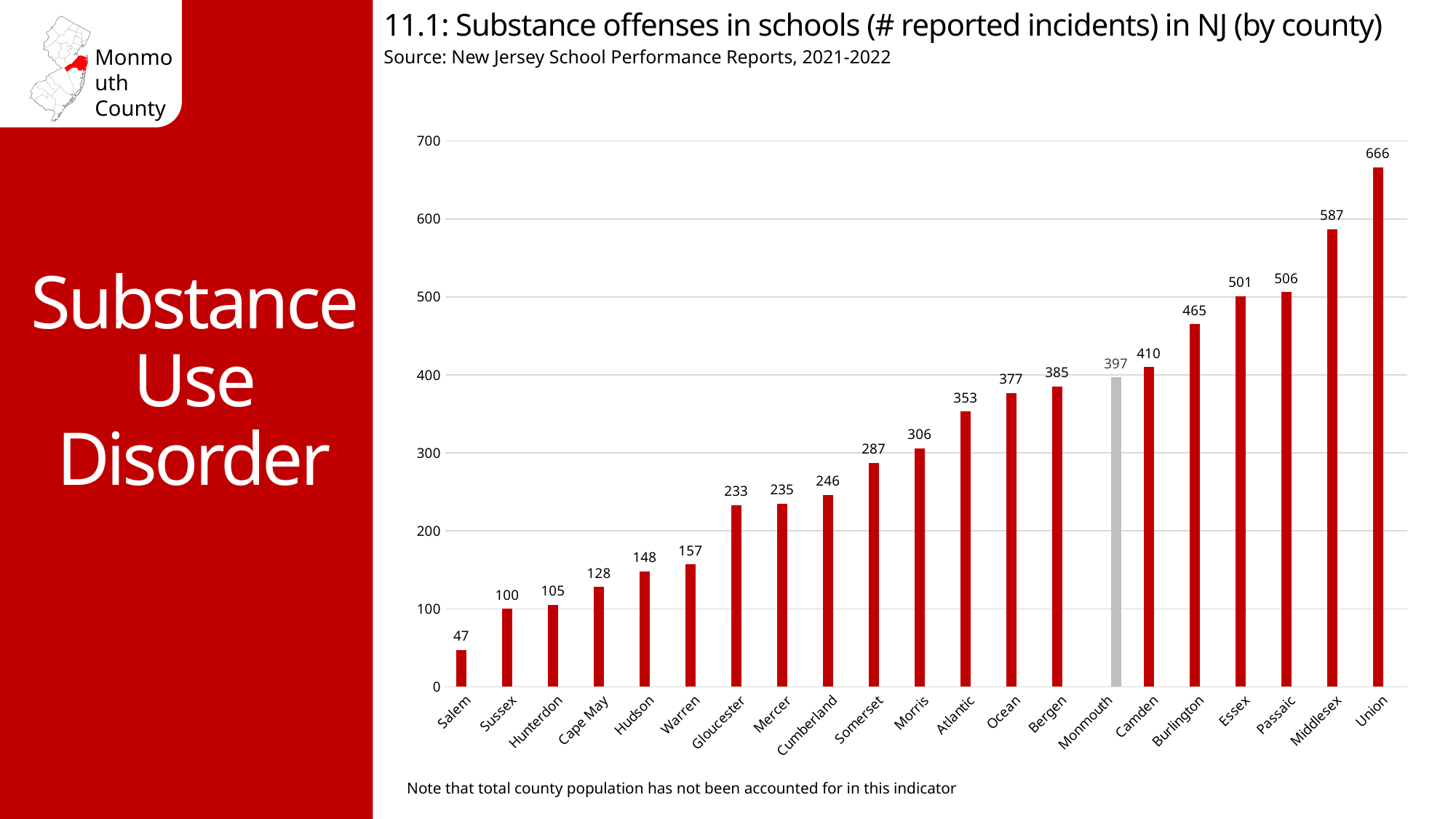
What is the difference between the values for Middlesex and Monmouth? 190 Which county has a larger value, Camden or Bergen? Camden Do the values rise or fall moving from left to right along the x axis? Rise Is the value for Essex greater or less than 400? greater What is the number of reported substance offense incidents in schools for Monmouth County? 397 What is the value shown for Union County? 666 Which county has the lowest number of reported incidents? Salem How many counties are shown on the chart? 21 What kind of chart is shown on the slide? Bar chart Which county's bar is coloured grey instead of red? Monmouth Which county has the highest number of reported incidents? Union What is the value shown for Gloucester County? 233